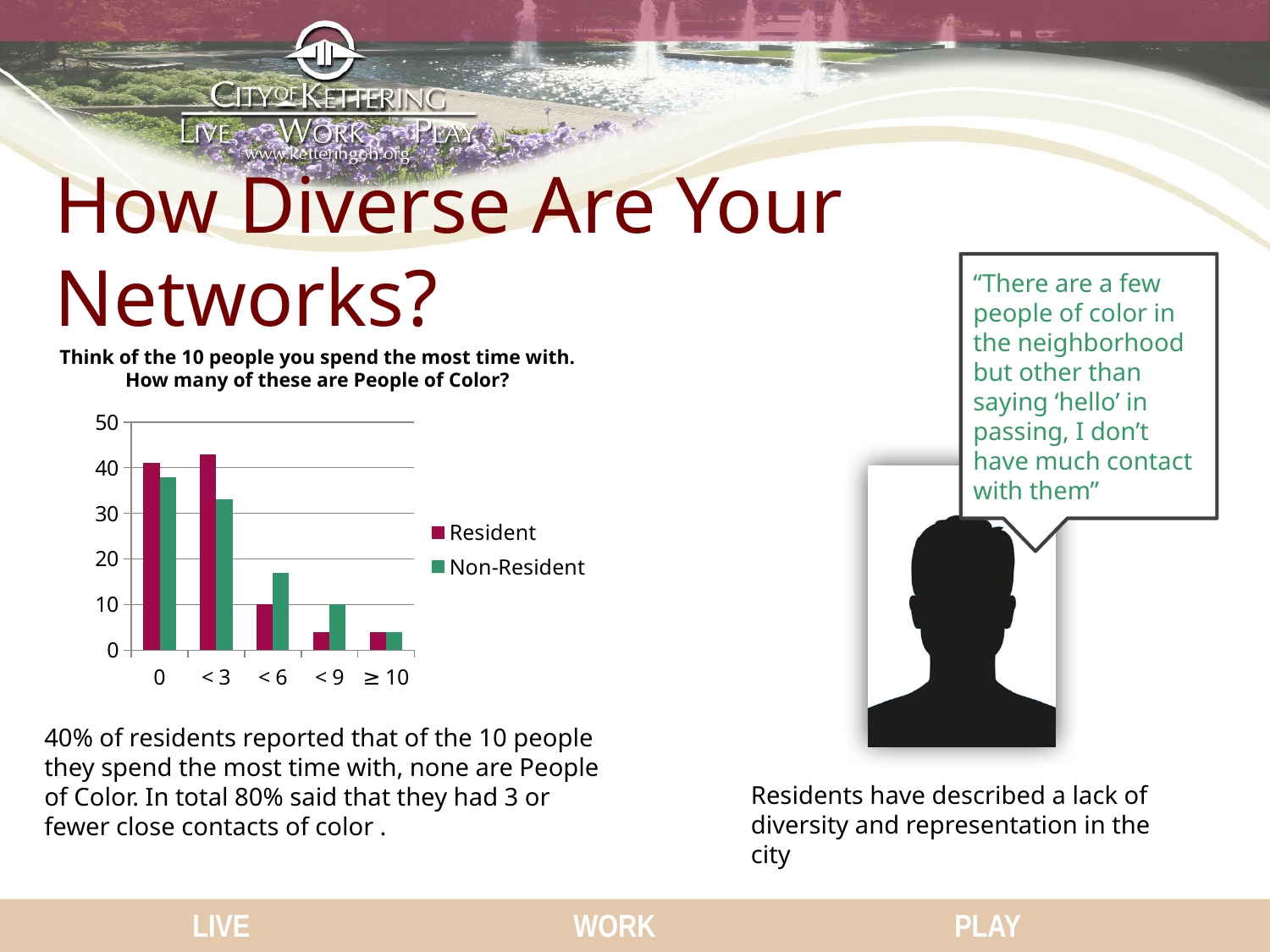
Do the Non-Resident values rise or fall moving from '0' to '≥ 10' along the x axis? fall How many series does the chart legend list? 2 Is the Resident value for '< 6' greater or less than 20? less What is the title of the chart? Think of the 10 people you spend the most time with. How many of these are People of Color? Which category has the highest Non-Resident value? 0 For the category '< 3', which series has the larger value, Resident or Non-Resident? Resident For the category '< 6', which series has the larger value, Resident or Non-Resident? Non-Resident For the category '< 9', which series has the larger value, Resident or Non-Resident? Non-Resident Is the Non-Resident value for '< 3' greater or less than 30? greater Which category has the lowest Non-Resident value? ≥ 10 How many categories are shown on the x axis of the chart? 5 What kind of chart is shown on the slide? bar chart